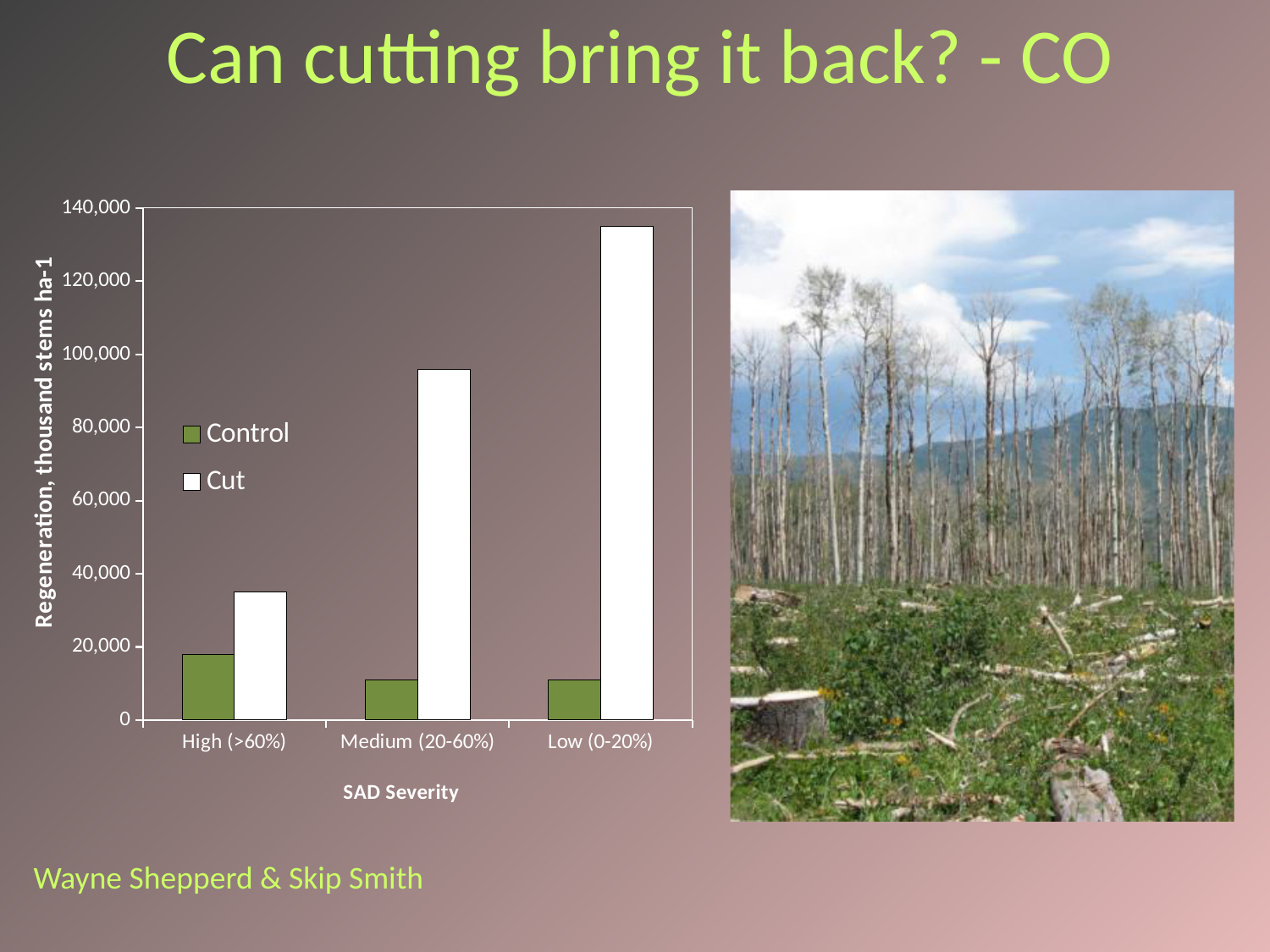
How many series does the chart legend list? 2 Is the Cut value for Low (0-20%) greater or less than 120,000? greater Is the Cut value for High (>60%) greater or less than 40,000? less Which SAD severity category has the highest Control regeneration value? High (>60%) Is the Cut value for Medium (20-60%) greater or less than 80,000? greater Which SAD severity category has the highest Cut regeneration value? Low (0-20%) Do the Cut values rise or fall moving from High (>60%) to Low (0-20%) along the x axis? rise What kind of chart is shown on the slide? bar chart For Medium (20-60%) SAD severity, which is larger, the Control value or the Cut value? Cut Which SAD severity category has the lowest Cut regeneration value? High (>60%) How many SAD severity categories are shown on the x axis? 3